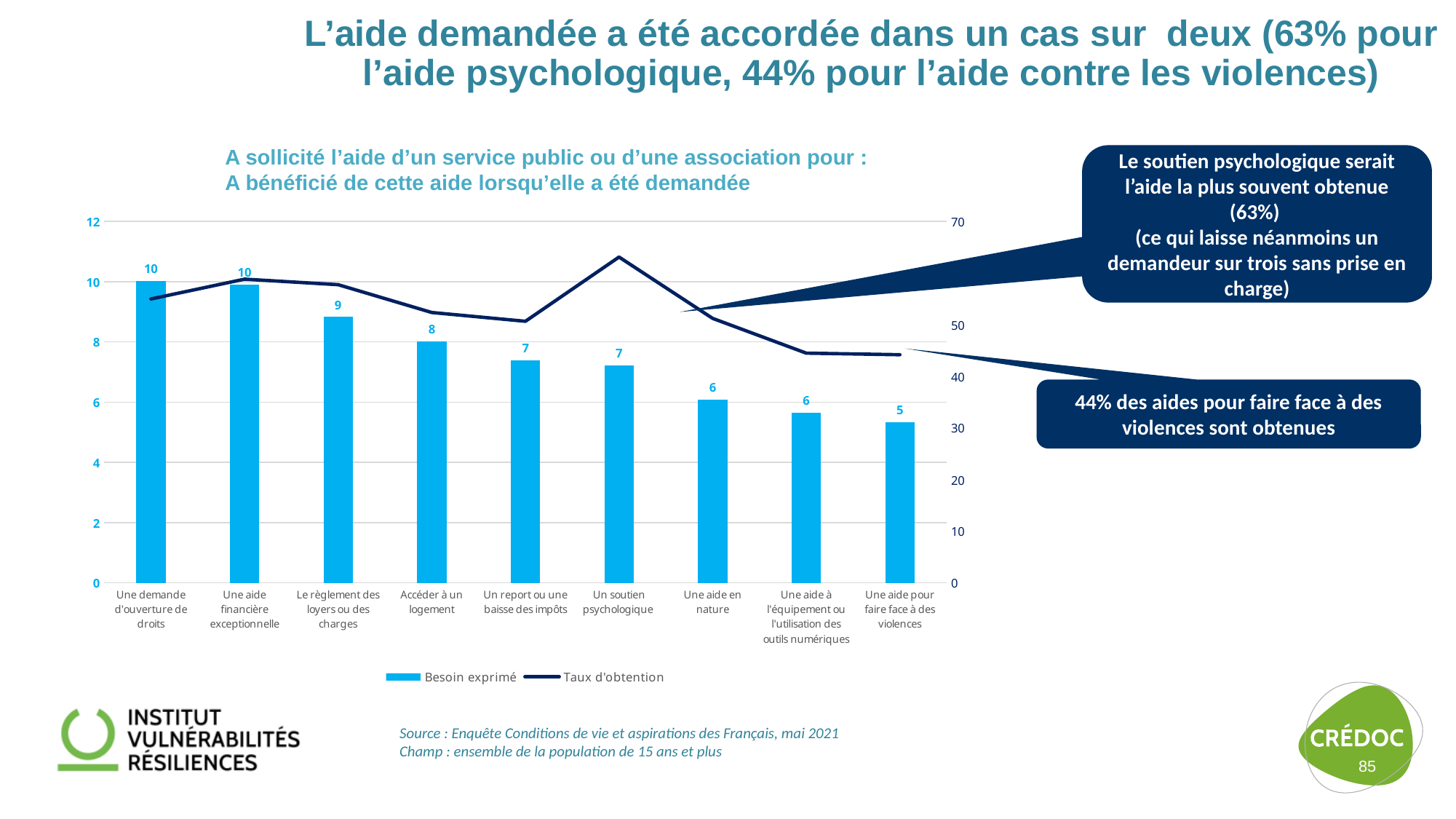
Which category has the highest Taux d'obtention on the line? Un soutien psychologique What is the value of Besoin exprimé for "Une aide pour faire face à des violences"? 5 Is the Taux d'obtention for "Une aide financière exceptionnelle" greater or less than 50? greater Which has a higher Besoin exprimé: "Le règlement des loyers ou des charges" or "Accéder à un logement"? Le règlement des loyers ou des charges What is the difference in Besoin exprimé between "Une demande d'ouverture de droits" and "Une aide pour faire face à des violences"? 5 How many series does the chart legend list? 2 What is the value of Besoin exprimé for "Le règlement des loyers ou des charges"? 9 Is the Taux d'obtention for "Une aide pour faire face à des violences" greater or less than 50? less How many categories are shown on the x axis of the chart? 9 Which category has the lowest Besoin exprimé bar? Une aide pour faire face à des violences Do the Besoin exprimé bars rise or fall from left to right along the x axis? fall What is the value of Besoin exprimé for "Un soutien psychologique"? 7